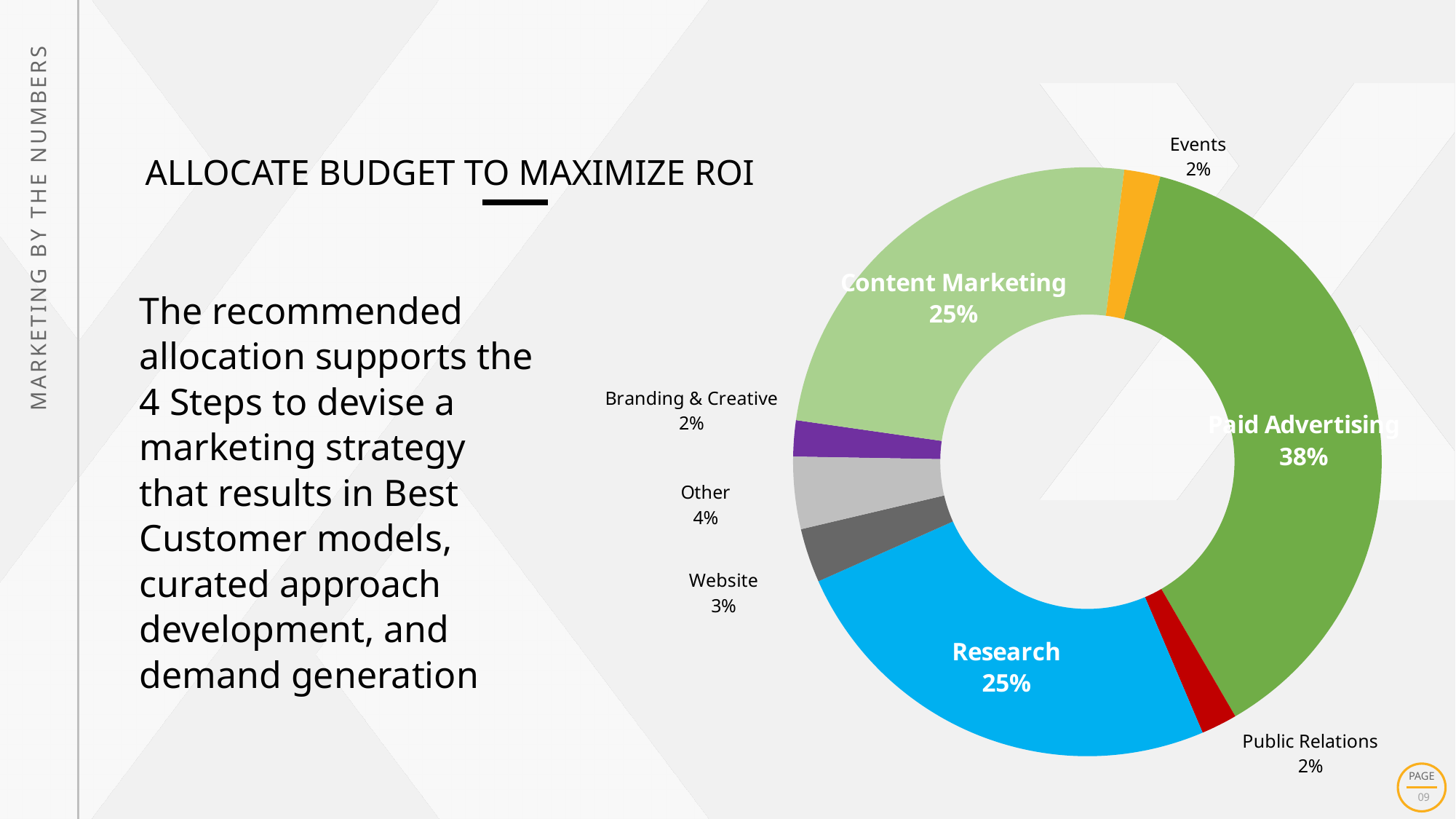
What is the combined share of Content Marketing and Research? 50% What percentage is shown for Website? 3% What percentage is shown for Other? 4% How many categories are shown in the chart? 8 What kind of chart is shown on the slide? Doughnut chart Which is larger, the share for Other or the share for Website? Other Which category has the largest share of the budget? Paid Advertising Which categories each have a 2% share? Events, Branding & Creative, Public Relations What percentage is shown for Content Marketing? 25% What share of the budget is allocated to Paid Advertising? 38% What colour is the Research segment? Blue What is the difference between the Paid Advertising share and the Research share? 13%